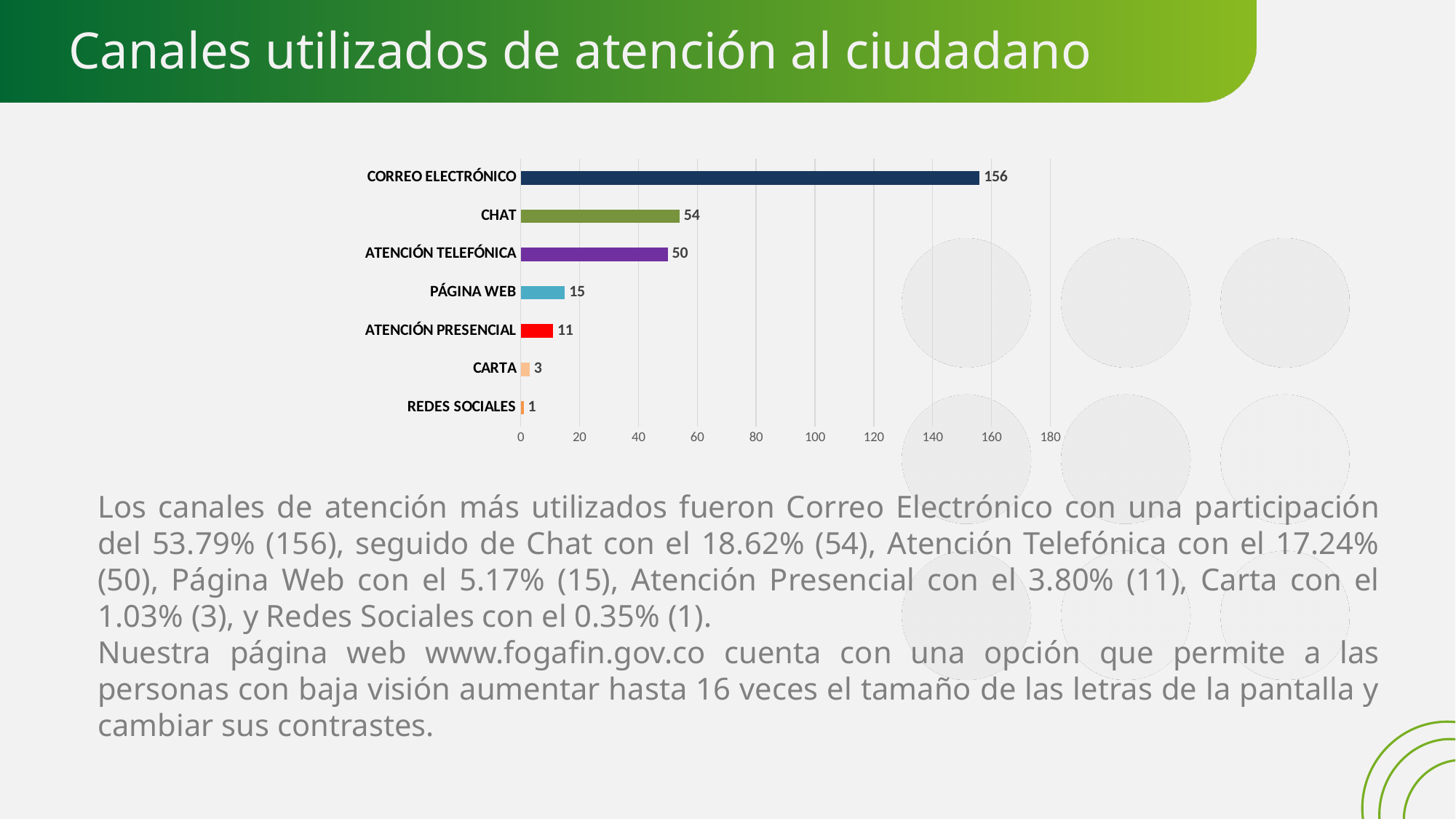
Which is larger, the value for PÁGINA WEB or the value for ATENCIÓN PRESENCIAL? PÁGINA WEB What is the value for ATENCIÓN TELEFÓNICA? 50 What is the difference between the values for CHAT and ATENCIÓN TELEFÓNICA? 4 What is the value for CORREO ELECTRÓNICO? 156 What is the title of the slide containing the chart? Canales utilizados de atención al ciudadano Which category has the highest value? CORREO ELECTRÓNICO Is the value for CORREO ELECTRÓNICO greater or less than 140? greater How many categories are shown in the chart? 7 What is the difference between the values for CORREO ELECTRÓNICO and CHAT? 102 What kind of chart is shown on the slide? bar chart What is the value for CARTA? 3 Which category has the lowest value? REDES SOCIALES